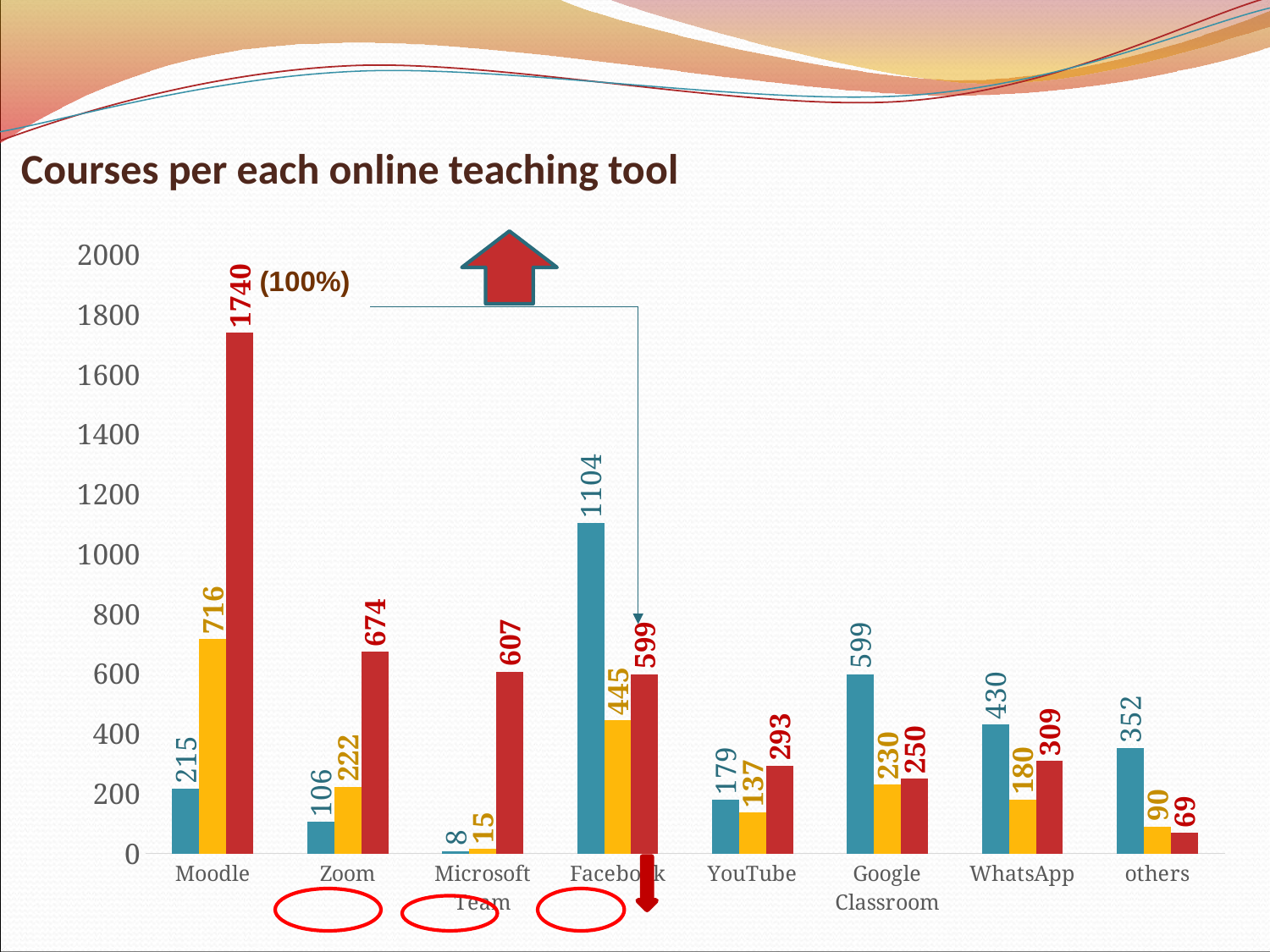
What is the value of the blue bar for Facebook? 1104 What is the difference between the red bar for Moodle and the red bar for Zoom? 1066 Which is larger, the blue bar for Google Classroom or the blue bar for WhatsApp? Google Classroom How many categories are shown on the x axis? 8 What is the title of the slide? Courses per each online teaching tool Which category has the highest red bar? Moodle What is the value of the red bar for Microsoft Team? 607 What is the value of the yellow bar for Zoom? 222 How many bars are shown for each category? 3 What kind of chart is shown on the slide? Bar chart Which category has the lowest blue bar? Microsoft Team What is the value of the red bar for Moodle? 1740